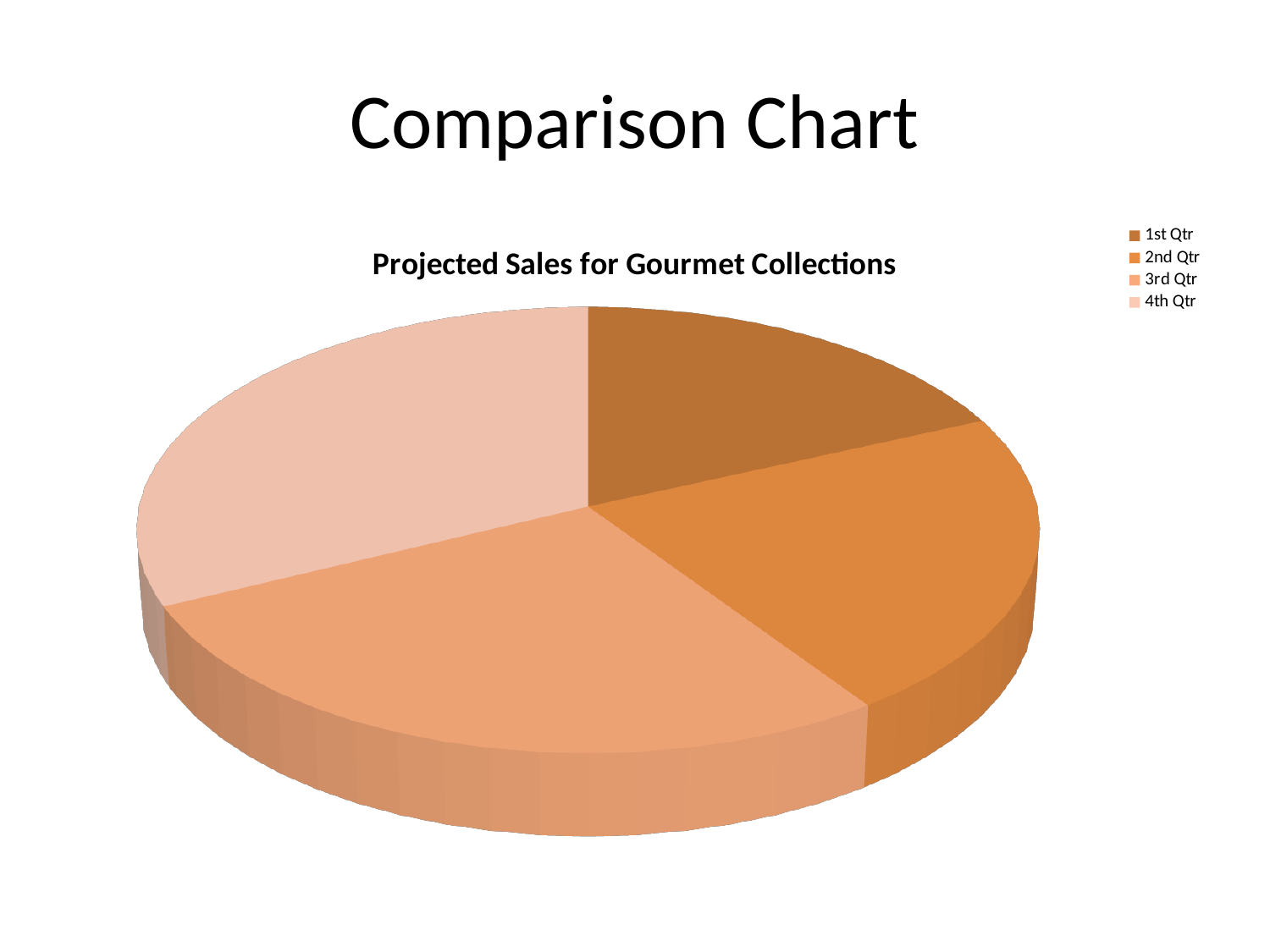
Which legend entry is listed first? 1st Qtr What is the title of the chart? Projected Sales for Gourmet Collections What kind of chart is shown on the slide? pie chart Which slice is larger, 2nd Qtr or 4th Qtr? 4th Qtr Which quarter has the smallest slice of the pie? 1st Qtr Which quarter has the largest slice of the pie? 4th Qtr Which slice is larger, 4th Qtr or 1st Qtr? 4th Qtr How many entries does the legend list? 4 How many slices does the pie chart have? 4